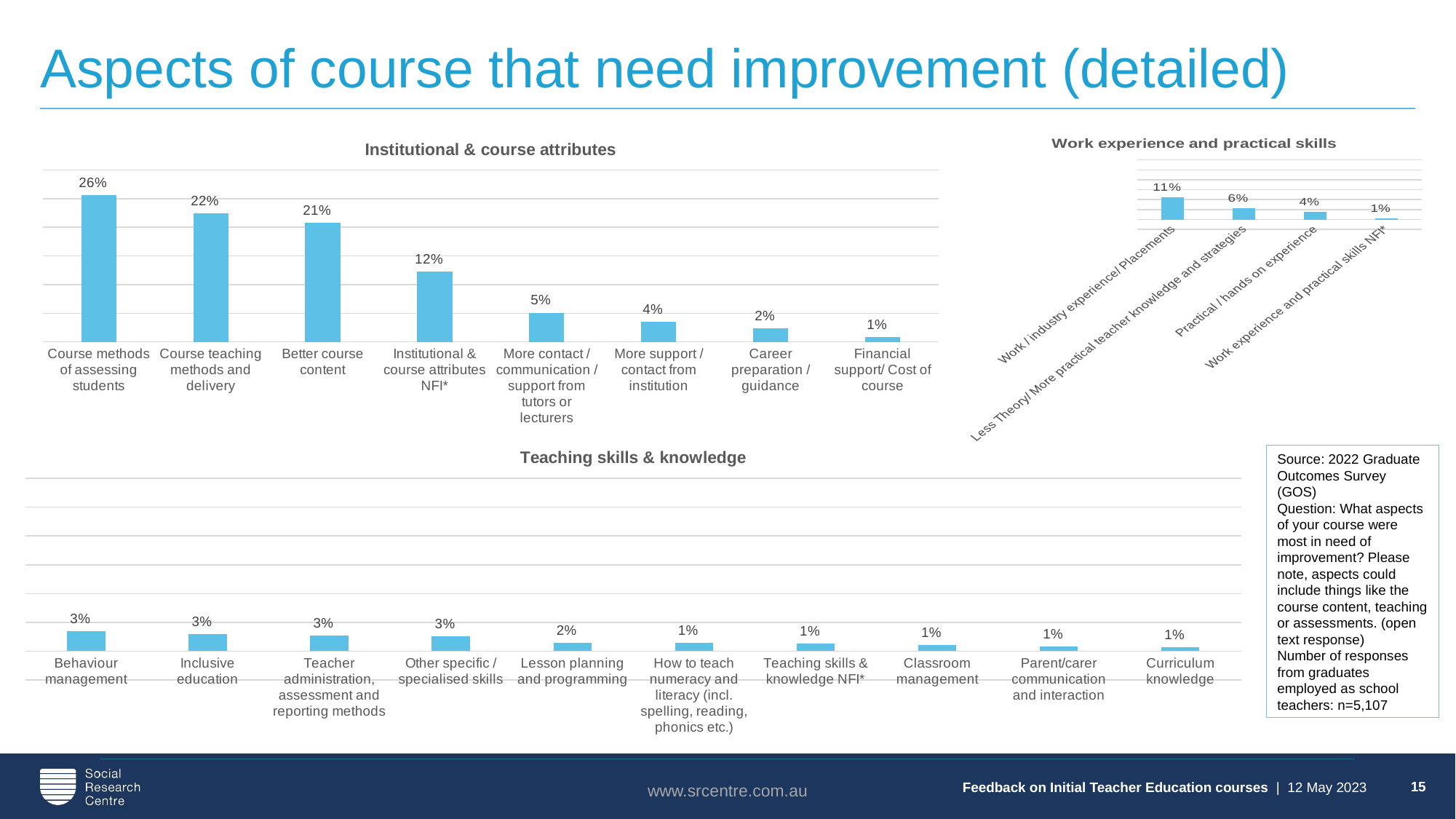
In the 'Work experience and practical skills' chart, which category has the highest value? Work / industry experience/ Placements In the 'Institutional & course attributes' chart, how many categories are shown? 8 What type of chart is the 'Teaching skills & knowledge' chart? Bar chart In the 'Teaching skills & knowledge' chart, how many categories are shown? 10 In the 'Work experience and practical skills' chart, what is the value for 'Work / industry experience/ Placements'? 11% In the 'Teaching skills & knowledge' chart, what is the value for 'Lesson planning and programming'? 2% In the 'Institutional & course attributes' chart, what is the value for 'Course methods of assessing students'? 26% In the 'Teaching skills & knowledge' chart, which is larger: 'Behaviour management' or 'Classroom management'? Behaviour management In the 'Work experience and practical skills' chart, what is the difference between 'Less Theory/ More practical teacher knowledge and strategies' and 'Practical / hands on experience'? 2% In the 'Institutional & course attributes' chart, which category has the lowest value? Financial support/ Cost of course In the 'Institutional & course attributes' chart, do the values rise or fall from left to right? Fall In the 'Institutional & course attributes' chart, what is the difference between 'Course teaching methods and delivery' and 'Better course content'? 1%